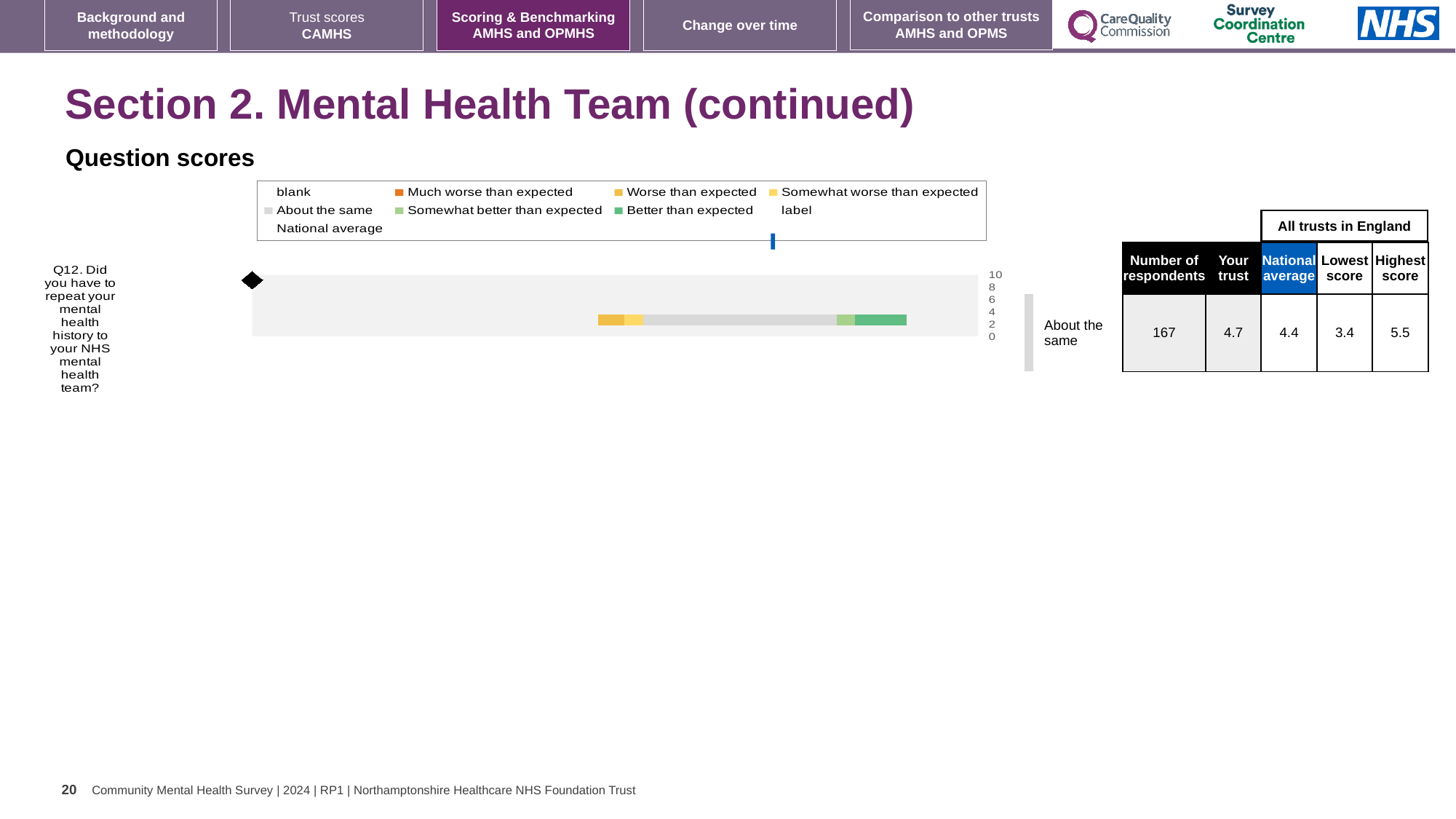
What colour does the legend use for 'Much worse than expected'? orange Which is larger for Q12, the 'Your trust' score or the national average? Your trust What is the difference between the 'Your trust' score and the national average for Q12? 0.3 Which benchmarking category is shown for Q12 (Did you have to repeat your mental health history to your NHS mental health team?)? About the same What is the difference between the highest and lowest scores among all trusts in England for Q12? 2.1 What is the lowest score among all trusts in England for Q12? 3.4 What is the national average score for Q12? 4.4 What kind of chart is used to show the question score for Q12? bar chart How many survey questions are plotted on the chart? 1 What is the highest score among all trusts in England for Q12? 5.5 What is the 'Your trust' score for Q12? 4.7 How many respondents answered Q12? 167